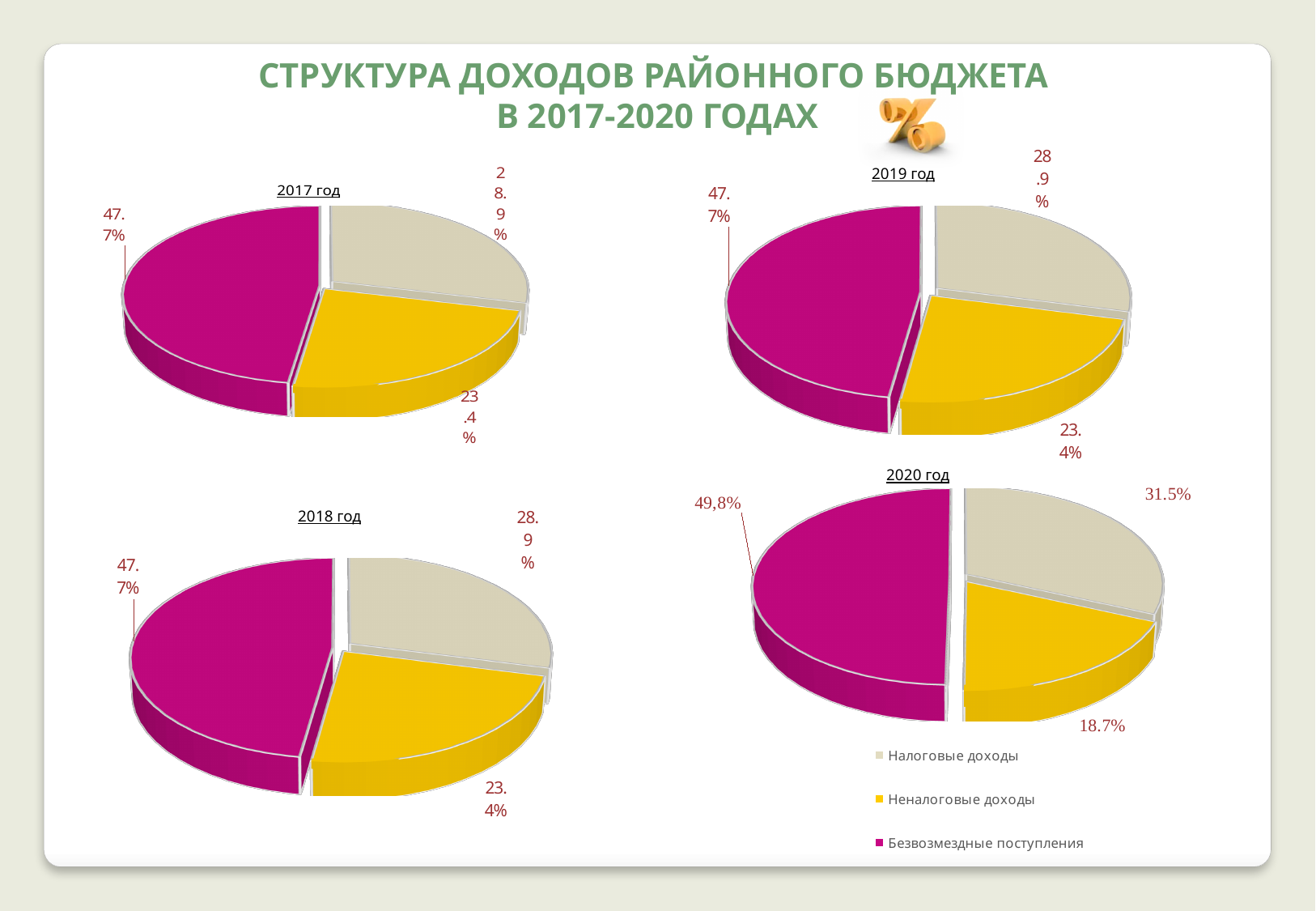
In the 2020 год chart, what share is labelled for Неналоговые доходы (the yellow slice)? 18.7% How many slices does the 2017 год chart have? 3 In the 2020 год chart, which category has the largest slice? Безвозмездные поступления In the 2020 год chart, which category has the smallest slice? Неналоговые доходы In the 2020 год chart, what is the difference between the Налоговые доходы share and the Неналоговые доходы share? 12.8% What type of chart is used for each year on this slide? Pie chart In the 2019 год chart, which is larger: Налоговые доходы or Неналоговые доходы? Налоговые доходы In the 2020 год chart, what share is labelled for Безвозмездные поступления (the magenta slice)? 49,8% In the 2020 год chart, what share is labelled for Налоговые доходы (the beige slice)? 31.5% In the 2017 год chart, what share is labelled for Безвозмездные поступления? 47.7% In the 2019 год chart, what share is labelled for Неналоговые доходы? 23.4% In the 2018 год chart, what share is labelled for Налоговые доходы? 28.9%